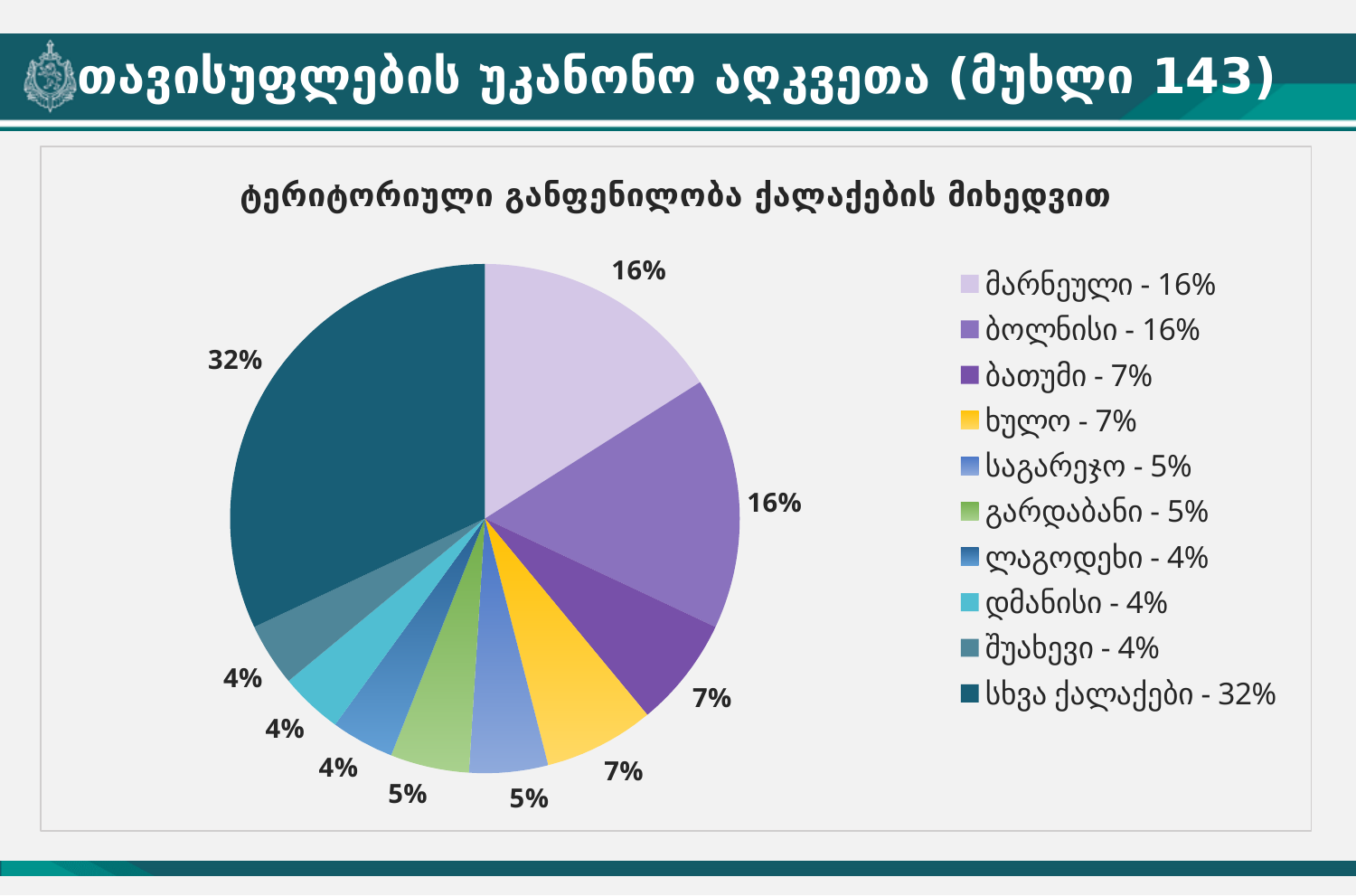
Which is larger, the value for ბათუმი or the value for გარდაბანი? ბათუმი What share of the pie does სხვა ქალაქები represent? 32% What is the value for საგარეჯო? 5% What is the chart's title? ტერიტორიული განფენილობა ქალაქების მიხედვით What is the difference between the value for ბოლნისი and the value for ხულო? 9% What is the difference between the value for სხვა ქალაქები and the value for მარნეული? 16% How many slices does the pie chart have? 10 What kind of chart is shown on the slide? pie chart Which category has the largest slice of the pie? სხვა ქალაქები How many entries does the legend list? 10 What is the value for ბათუმი? 7% What is the value for დმანისი? 4%